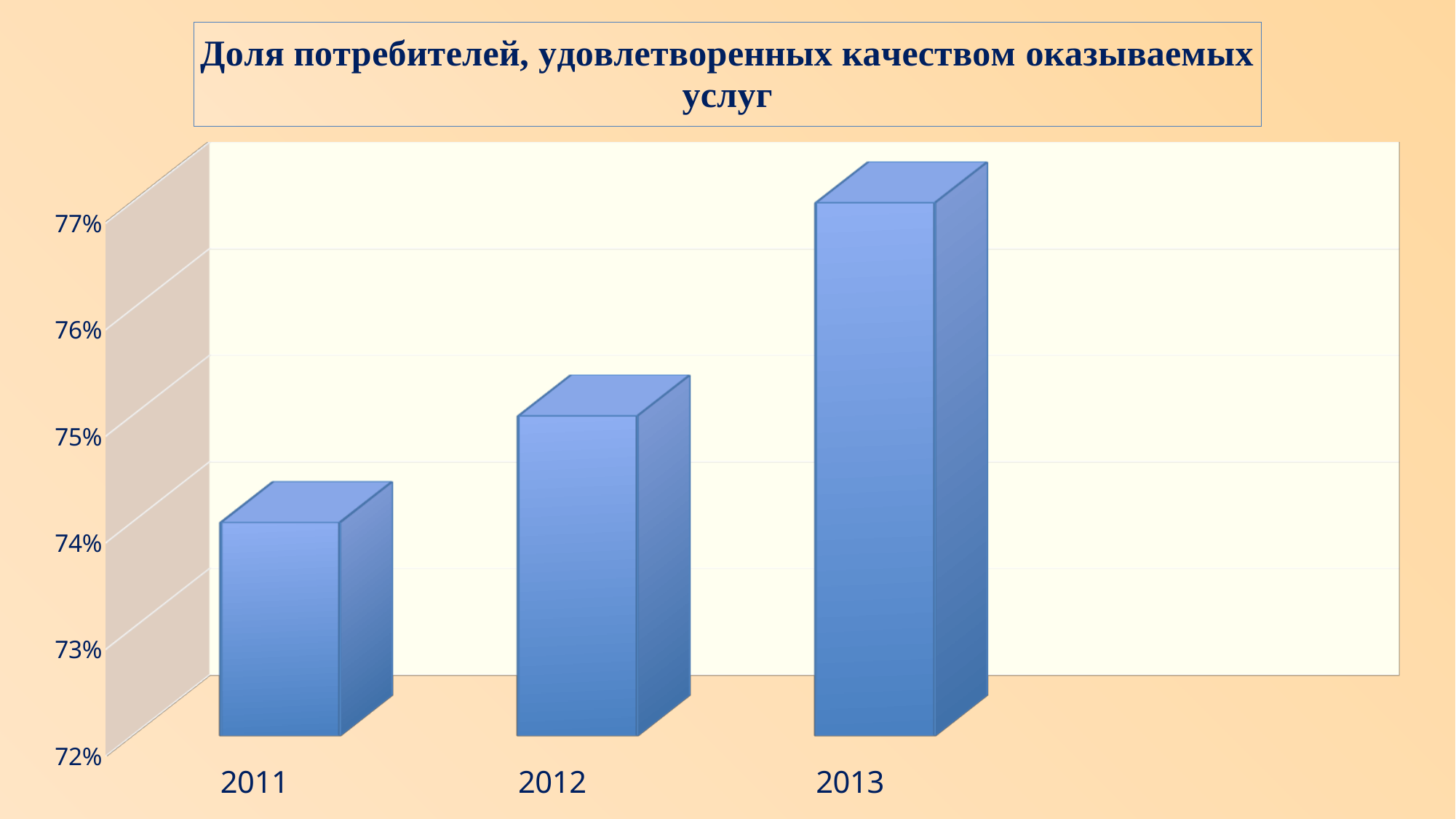
What kind of chart is shown on the slide? bar chart What is the title of the chart? Доля потребителей, удовлетворенных качеством оказываемых услуг Is the value for 2012 greater or less than 74%? greater Do the values rise or fall from 2011 to 2013? rise Which is larger, the value for 2012 or the value for 2013? 2013 Is the value for 2013 greater or less than 76%? greater Is the value for 2011 greater or less than 73%? greater Which year has the lowest share of satisfied consumers? 2011 Which year has the highest share of satisfied consumers? 2013 How many years are shown on the x axis of the chart? 3